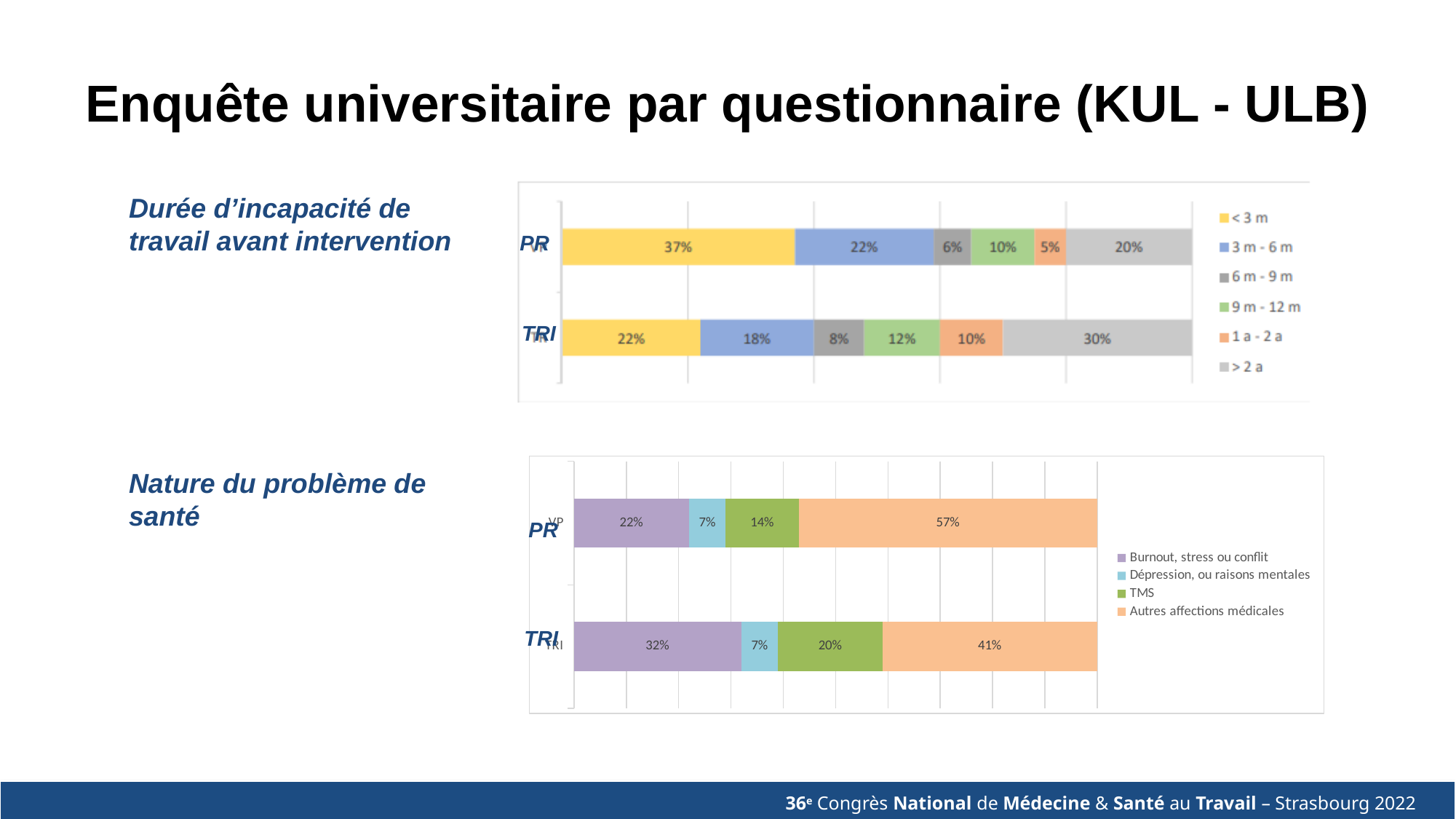
In the 'Nature du problème de santé' chart, how many series does the legend list? 4 In the 'Durée d'incapacité de travail avant intervention' chart, which segment is the largest in the PR bar? < 3 m In the 'Nature du problème de santé' chart, what is the value for 'Autres affections médicales' in the PR bar? 57% In the 'Durée d'incapacité de travail avant intervention' chart, what is the difference between the '3 m - 6 m' values for PR and TRI? 4% What type of chart is the 'Nature du problème de santé' chart? Stacked bar chart In the 'Durée d'incapacité de travail avant intervention' chart, how many series does the legend list? 6 In the 'Durée d'incapacité de travail avant intervention' chart, what is the value for '9 m - 12 m' in the TRI bar? 12% In the 'Nature du problème de santé' chart, which segment is the smallest in the PR bar? Dépression, ou raisons mentales In the 'Durée d'incapacité de travail avant intervention' chart, what is the value for '> 2 a' in the TRI bar? 30% In the 'Nature du problème de santé' chart, which bar has the larger 'TMS' value, PR or TRI? TRI In the 'Durée d'incapacité de travail avant intervention' chart, what is the value for '< 3 m' in the PR bar? 37% In the 'Nature du problème de santé' chart, what is the value for 'Burnout, stress ou conflit' in the TRI bar? 32%